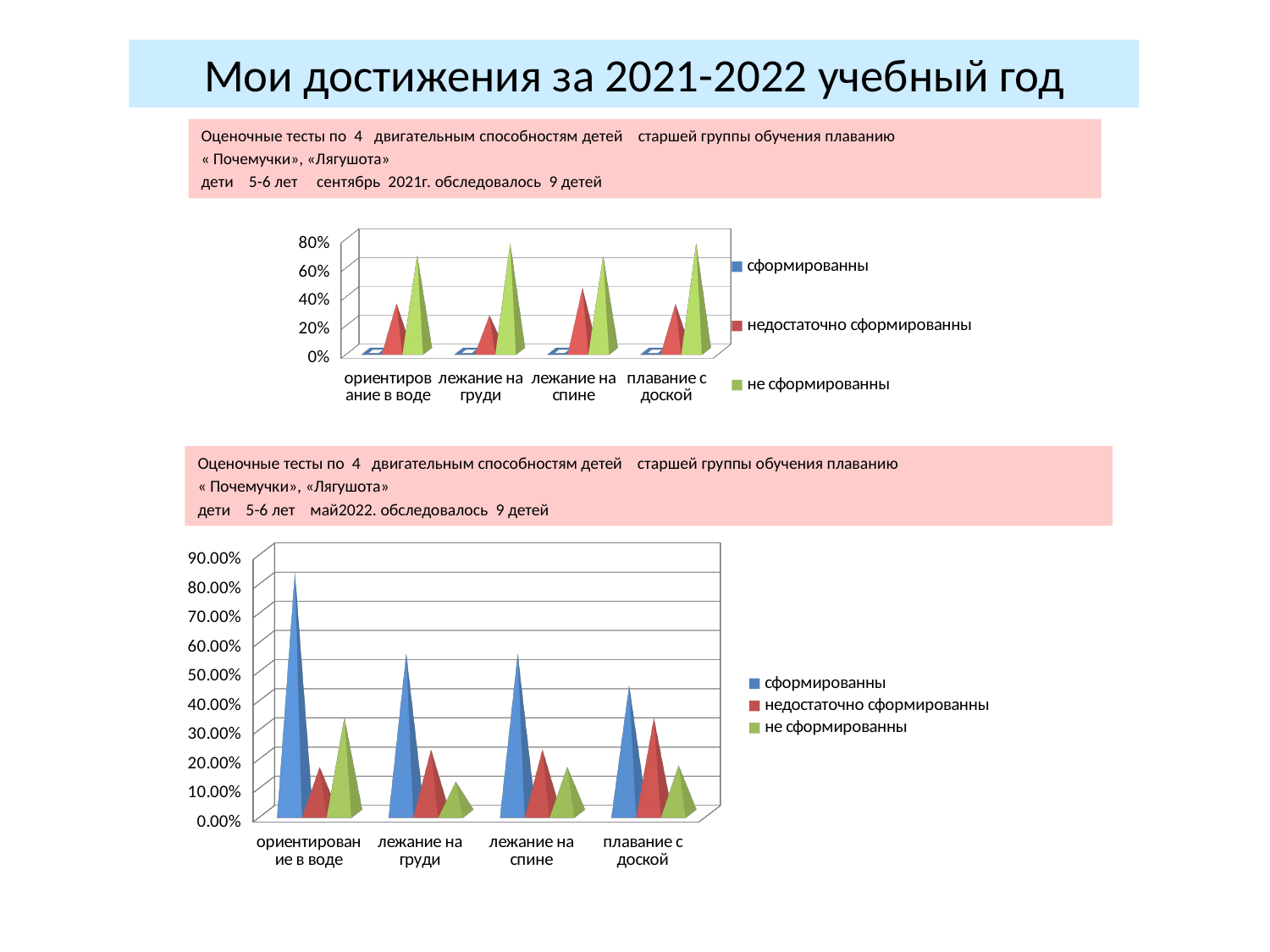
How many series does the legend of the top chart (September 2021) list? 3 In the bottom chart (May 2022), which category has the highest value for 'сформированны'? ориентирование в воде In the bottom chart (May 2022), is the value of 'сформированны' for 'ориентирование в воде' greater or less than 70.00%? greater What kind of chart is the top chart (September 2021)? bar chart In the top chart (September 2021), is the value of 'недостаточно сформированны' for 'лежание на спине' greater or less than 20%? greater In the top chart (September 2021), is the value of 'не сформированны' for 'лежание на груди' greater or less than 60%? greater In the bottom chart (May 2022), which category has the lowest value for 'сформированны'? плавание с доской In the bottom chart (May 2022), for 'плавание с доской', which is larger: 'сформированны' or 'не сформированны'? сформированны In the bottom chart (May 2022), what colour represents the series 'не сформированны'? green How many categories are shown on the x axis of the bottom chart (May 2022)? 4 In the bottom chart (May 2022), do the values of 'сформированны' generally rise or fall from left to right along the x axis? fall In the top chart (September 2021), which category has the highest value for 'недостаточно сформированны'? лежание на спине